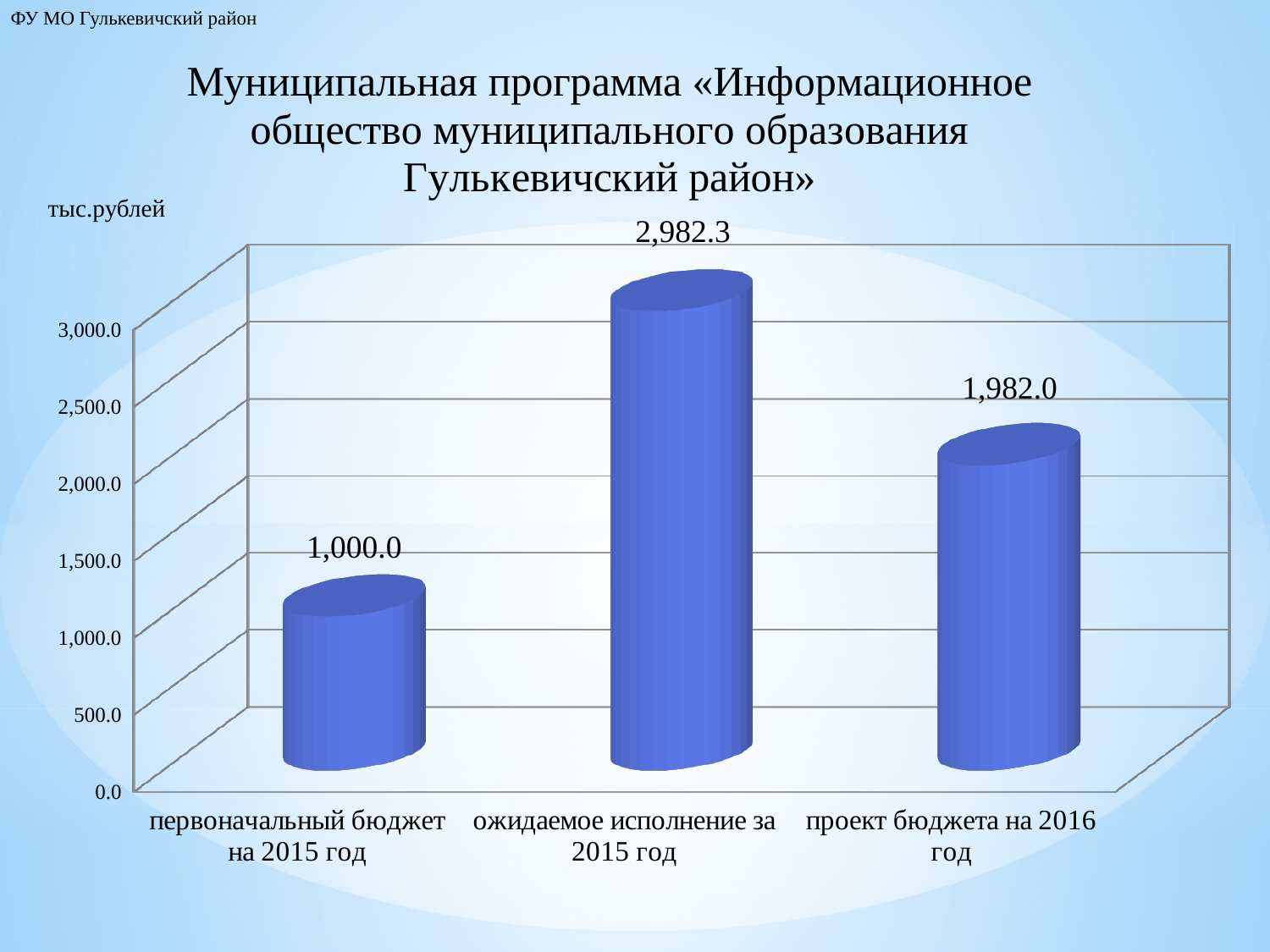
How many categories are shown in the chart? 3 What is the value for «ожидаемое исполнение за 2015 год»? 2,982.3 What is the value for «проект бюджета на 2016 год»? 1,982.0 Which is larger: «проект бюджета на 2016 год» or «первоначальный бюджет на 2015 год»? проект бюджета на 2016 год What is the difference between «ожидаемое исполнение за 2015 год» and «проект бюджета на 2016 год»? 1,000.3 What unit is indicated for the values in the chart? тыс.рублей What kind of chart is shown on the slide? bar chart Which category has the lowest value? первоначальный бюджет на 2015 год What is the difference between «проект бюджета на 2016 год» and «первоначальный бюджет на 2015 год»? 982.0 Is the value for «проект бюджета на 2016 год» greater or less than 2,500.0? less What is the value for «первоначальный бюджет на 2015 год»? 1,000.0 Which category has the highest value? ожидаемое исполнение за 2015 год